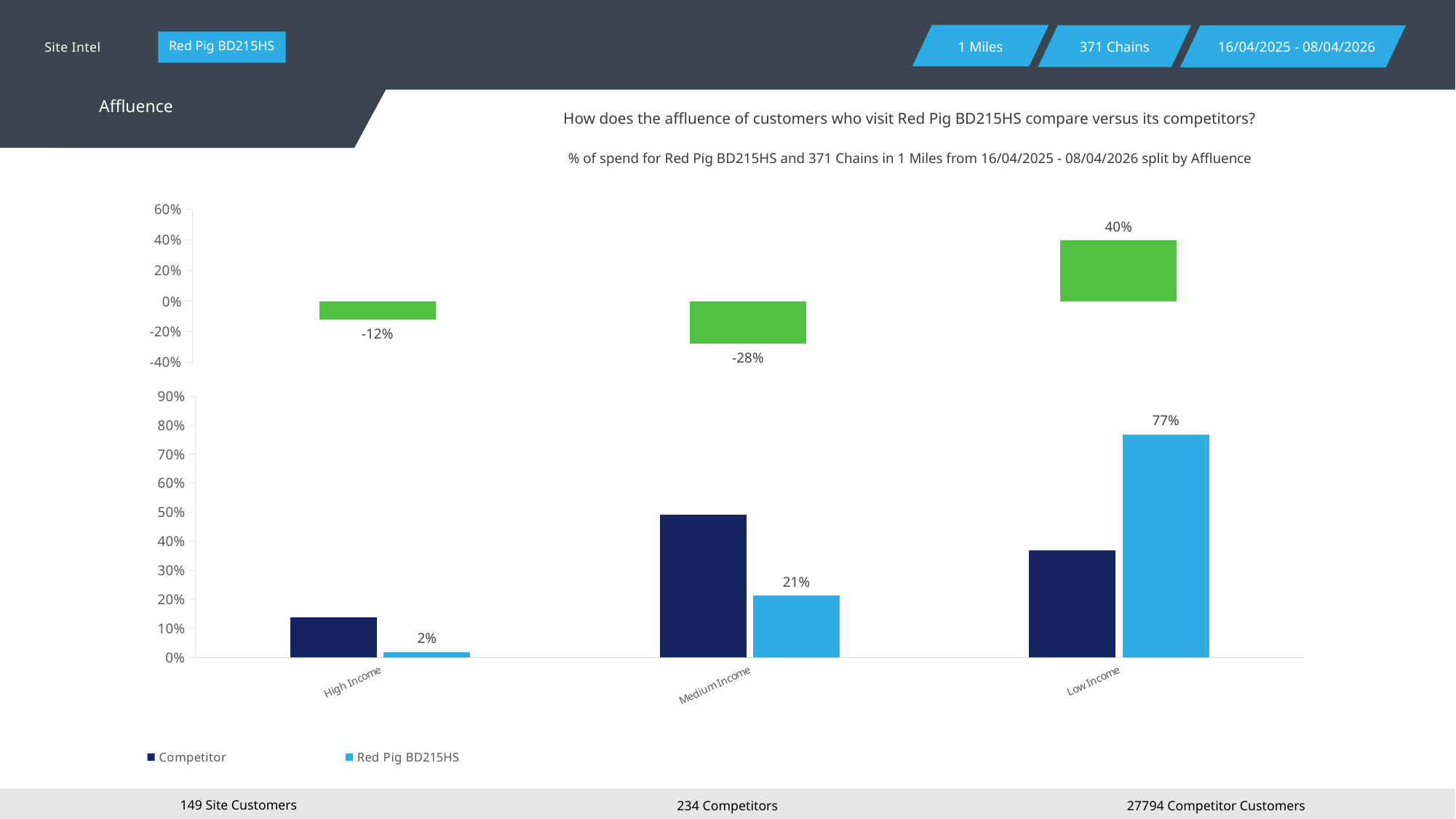
In the bottom chart, which is larger for Low Income: the Competitor value or the Red Pig BD215HS value? Red Pig BD215HS In the bottom chart, is the Competitor value for High Income greater or less than 20%? less In the bottom chart, is the Competitor value for Medium Income greater or less than 40%? greater How many series does the legend of the bottom chart list? 2 In the bottom chart, what is the value for Red Pig BD215HS in the Low Income category? 77% What kind of chart is the bottom chart? Bar chart In the bottom chart, what is the difference between the Red Pig BD215HS values for Low Income and Medium Income? 56% In the top chart, what is the value shown for Medium Income? -28% In the bottom chart, what is the value for Red Pig BD215HS in the High Income category? 2% How many categories are shown on the x axis of the bottom chart? 3